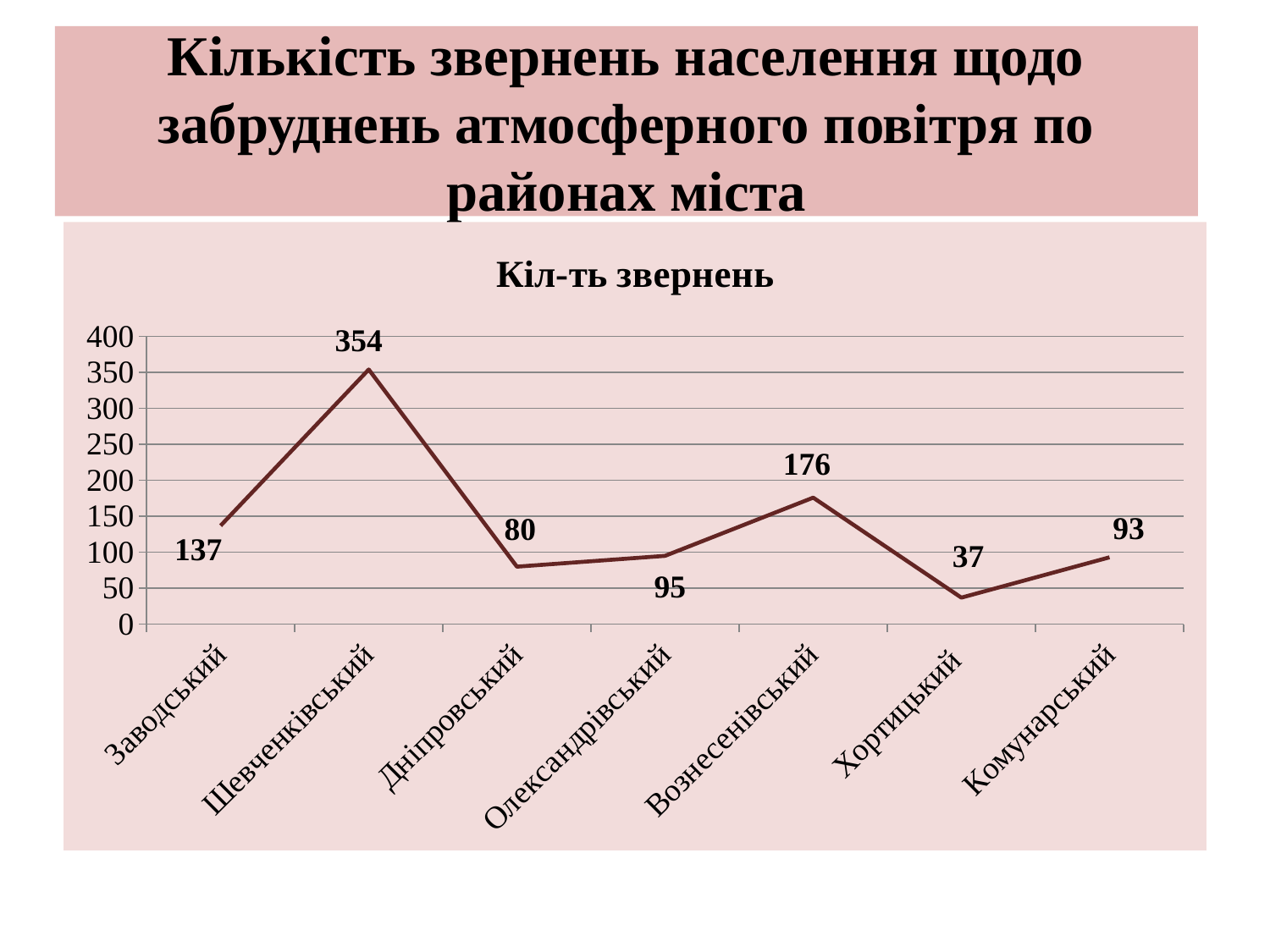
What is the value for Хортицький? 37 What is the value for Вознесенівський? 176 What is the value for Шевченківський? 354 Which district has the highest number of appeals? Шевченківський How many districts are plotted on the chart? 7 What is the difference between the values for Шевченківський and Вознесенівський? 178 What is the difference between the values for Комунарський and Хортицький? 56 Which is larger, the value for Олександрівський or the value for Дніпровський? Олександрівський Which district has the lowest number of appeals? Хортицький What is the title of the chart? Кіл-ть звернень What type of chart is shown on the slide? line chart What is the value for Заводський? 137